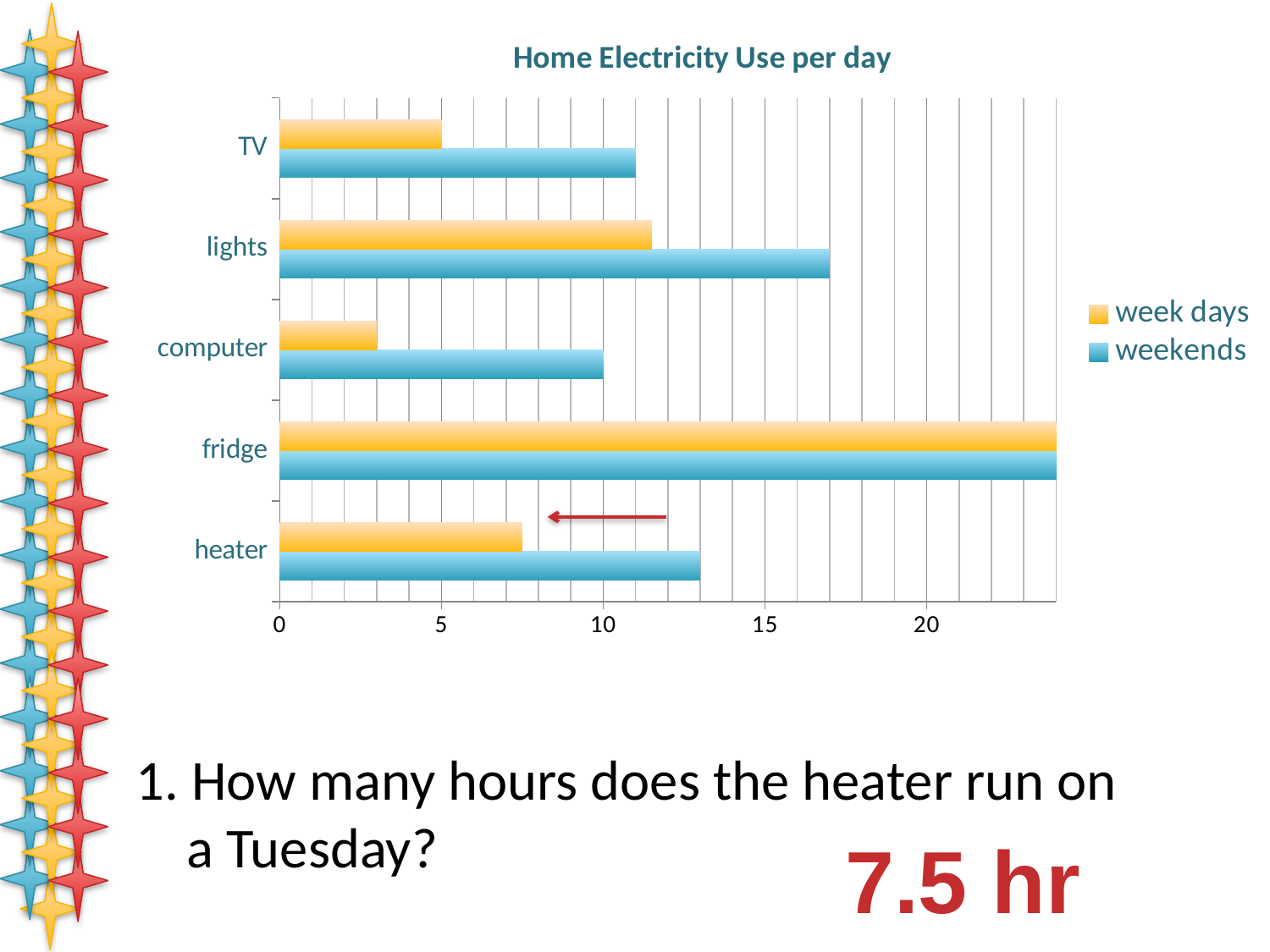
Which category has the highest weekends value? fridge How many series does the legend list? 2 Which is larger for lights: the week days value or the weekends value? weekends What is the title of the chart? Home Electricity Use per day What kind of chart is shown on the slide? bar chart Is the weekends value for lights greater or less than 15? greater What is the weekends value for computer? 10 Is the weekends value for heater greater or less than 15? less What is the week days value for TV? 5 How many categories are shown on the chart? 5 Which category has the lowest week days value? computer How many hours does the heater run on a week day? 7.5 hr